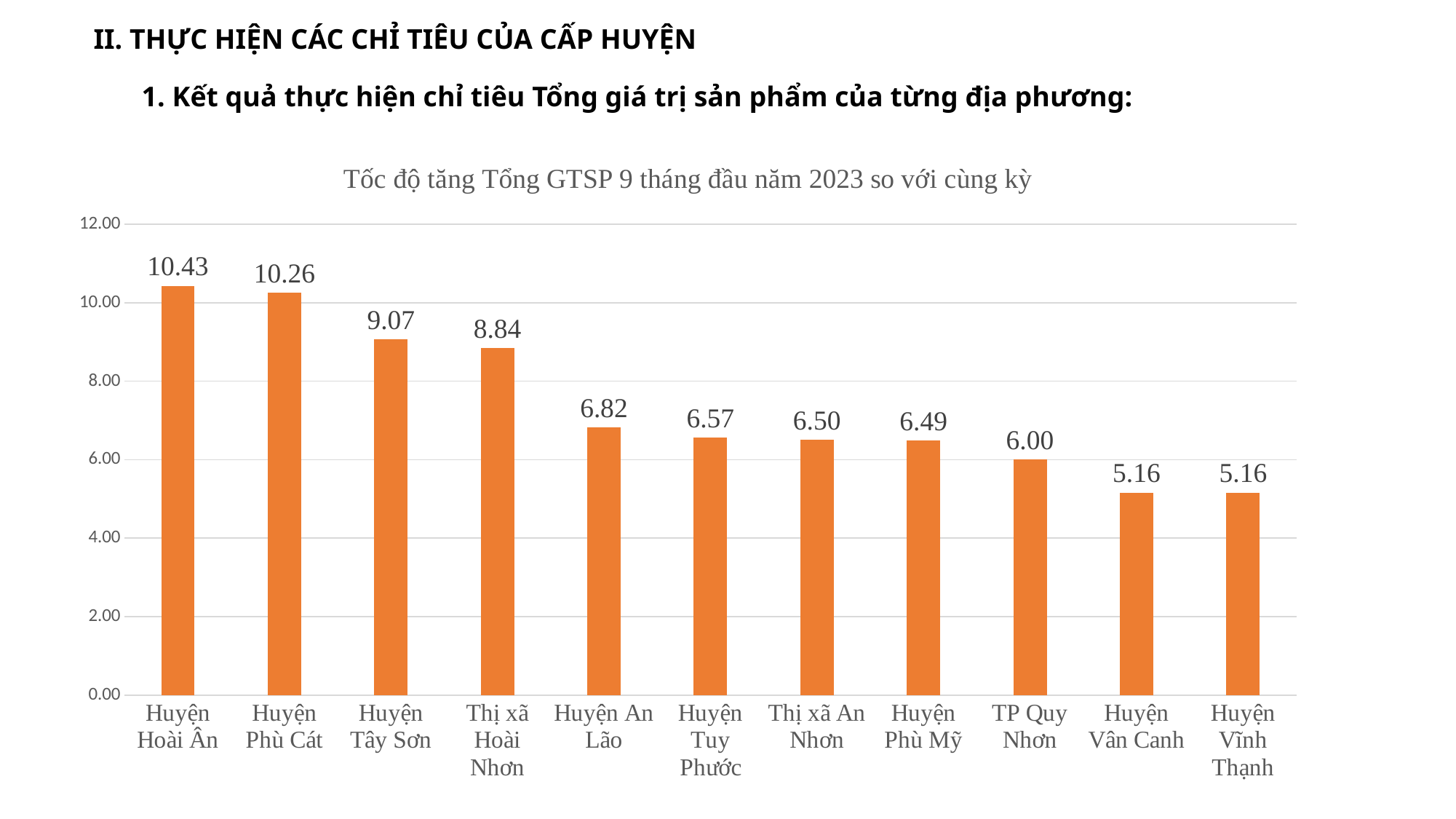
What kind of chart is shown on the slide? bar chart What is the value for Thị xã Hoài Nhơn? 8.84 What is the value for TP Quy Nhơn? 6.00 Which category has the highest value? Huyện Hoài Ân What is the title of the chart? Tốc độ tăng Tổng GTSP 9 tháng đầu năm 2023 so với cùng kỳ Is the value for Huyện Vân Canh greater or less than 6.00? less Do the values rise or fall from left to right along the x axis? fall What is the difference between the values for Huyện Tây Sơn and TP Quy Nhơn? 3.07 What is the value for Huyện Hoài Ân? 10.43 What is the difference between the values for Huyện Hoài Ân and Huyện Phù Cát? 0.17 Which is larger, the value for Huyện Tây Sơn or the value for Huyện An Lão? Huyện Tây Sơn How many categories are shown on the x axis? 11